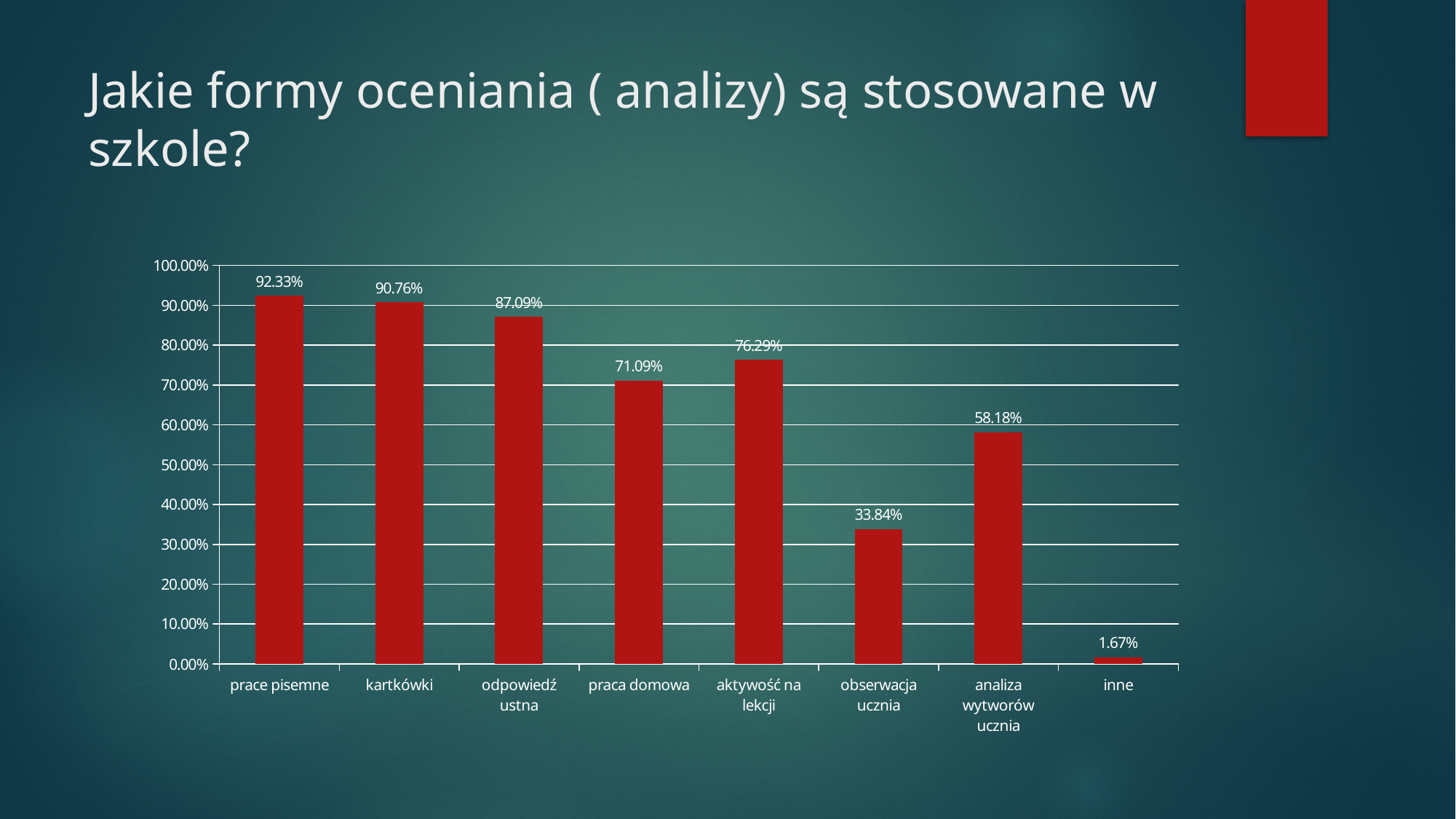
Is the value for odpowiedź ustna greater or less than 80.00%? greater What is the value for prace pisemne? 92.33% How many categories are shown on the chart? 8 What is the title of the slide? Jakie formy oceniania ( analizy) są stosowane w szkole? Which category has the highest value? prace pisemne What is the difference between the values for kartkówki and praca domowa? 19.67% What is the value for obserwacja ucznia? 33.84% What kind of chart is shown on the slide? bar chart Which is larger, the value for aktywość na lekcji or the value for praca domowa? aktywość na lekcji What colour are the bars in the chart? red What is the value for analiza wytworów ucznia? 58.18% Which category has the lowest value? inne